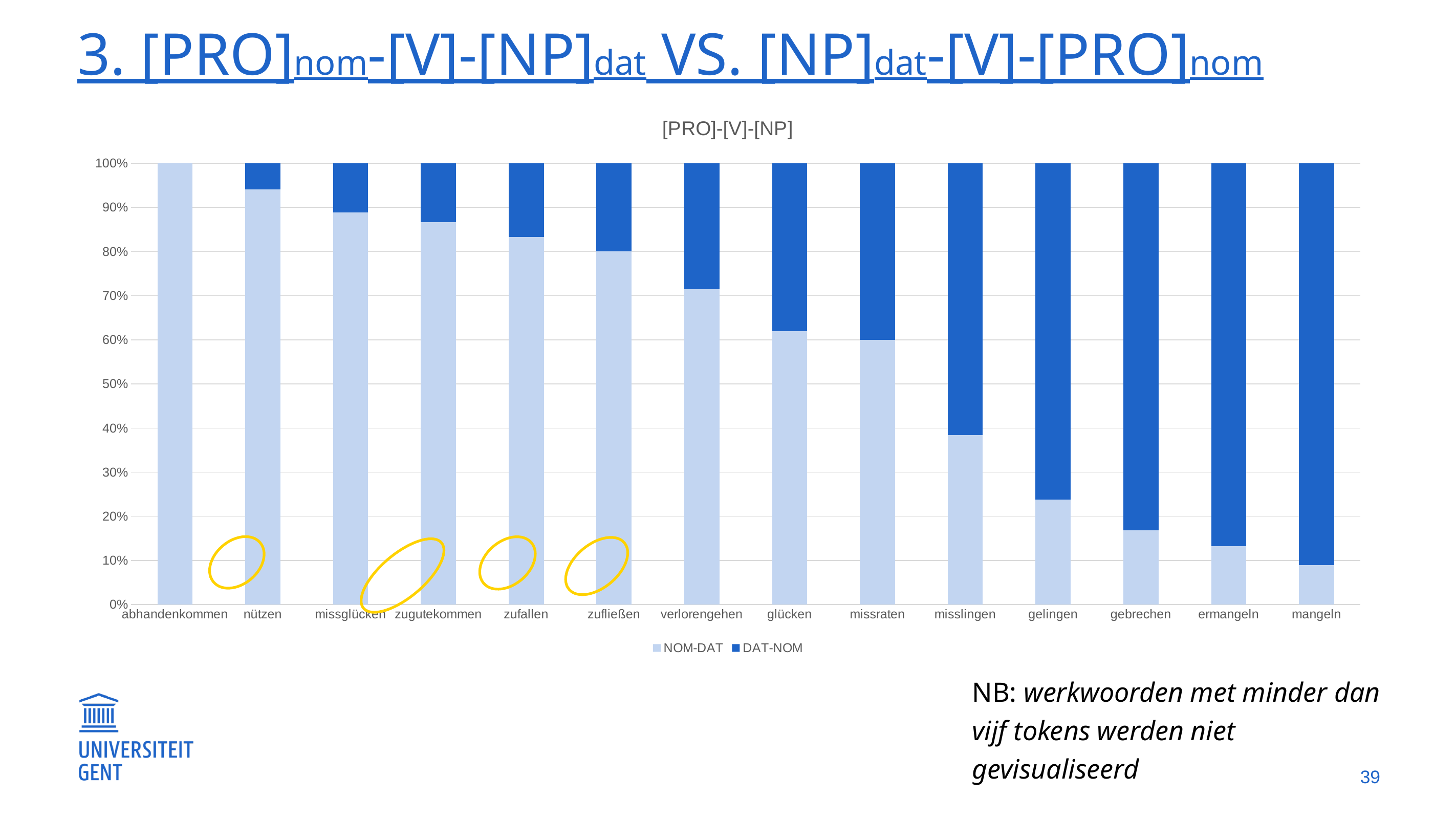
Does the NOM-DAT share rise or fall from left to right along the x axis? fall Is the NOM-DAT value for glücken greater or less than 50%? greater Which has the larger NOM-DAT share, nützen or gelingen? nützen Is the NOM-DAT value for gelingen greater or less than 30%? less Which verb has the lowest NOM-DAT share? mangeln How many verbs (categories) are shown on the x axis of the chart? 14 Which verb has the largest DAT-NOM share? mangeln Is the NOM-DAT value for nützen greater or less than 90%? greater What is the NOM-DAT value for abhandenkommen? 100% Which verb has the highest NOM-DAT share? abhandenkommen How many series does the chart legend list? 2 What kind of chart is shown on the slide? stacked bar chart